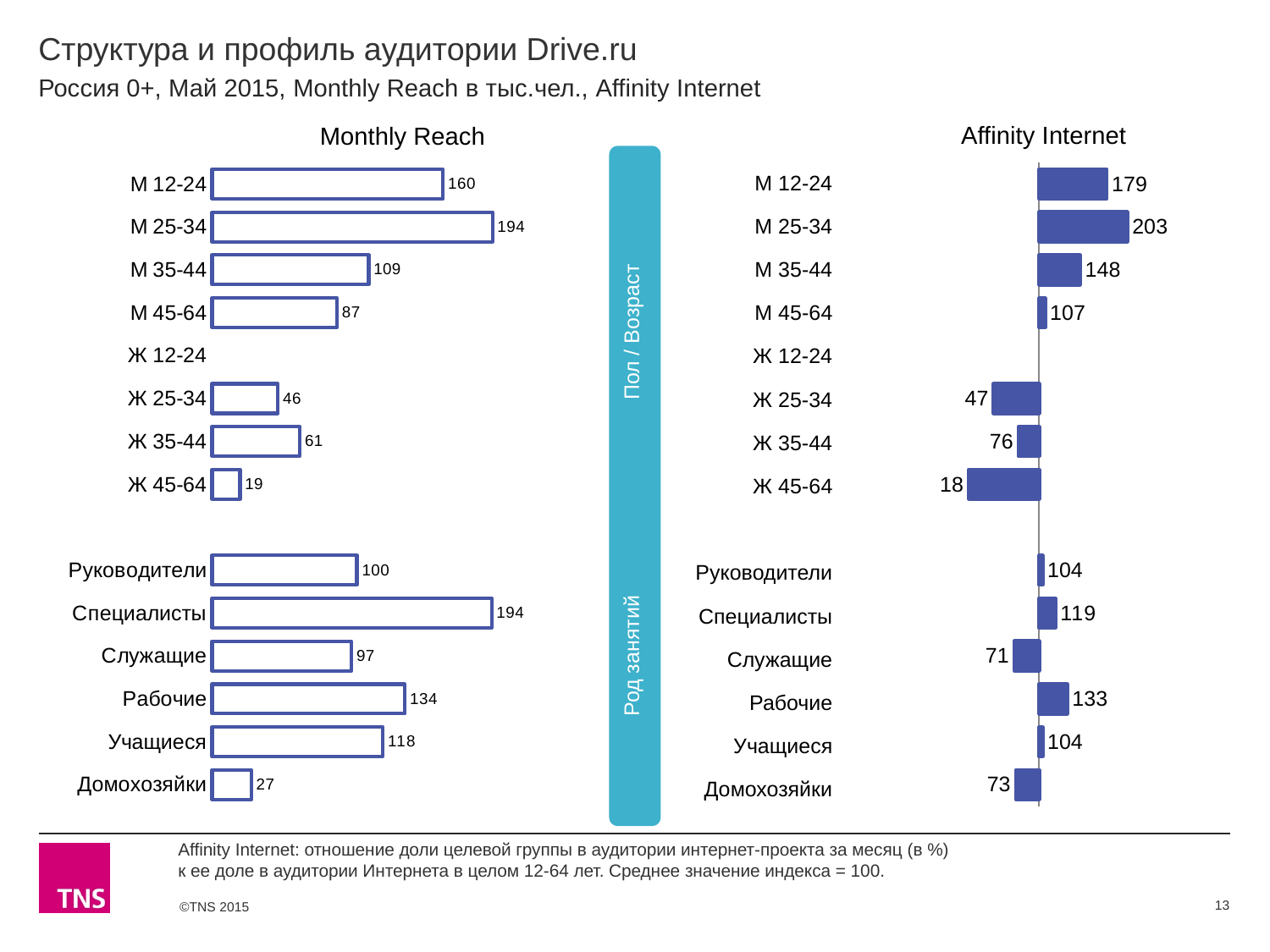
In the Monthly Reach chart, which is larger: Рабочие or Учащиеся? Рабочие In the Affinity Internet chart, what is the value for М 45-64? 107 In the Monthly Reach chart, what is the value for М 25-34? 194 What kind of chart is the Monthly Reach chart? Bar chart In the Monthly Reach chart, what is the difference between М 12-24 and М 35-44? 51 In the Affinity Internet chart, which is larger: Ж 25-34 or Ж 35-44? Ж 35-44 In the Monthly Reach chart, which category has the lowest value? Ж 45-64 In the Affinity Internet chart, what is the value for Рабочие? 133 In the Affinity Internet chart, what is the difference between Специалисты and Служащие? 48 In the Monthly Reach chart, what is the value for Домохозяйки? 27 In the Affinity Internet chart, which category has the highest value? М 25-34 In the Affinity Internet chart, which category has the lowest value? Ж 45-64